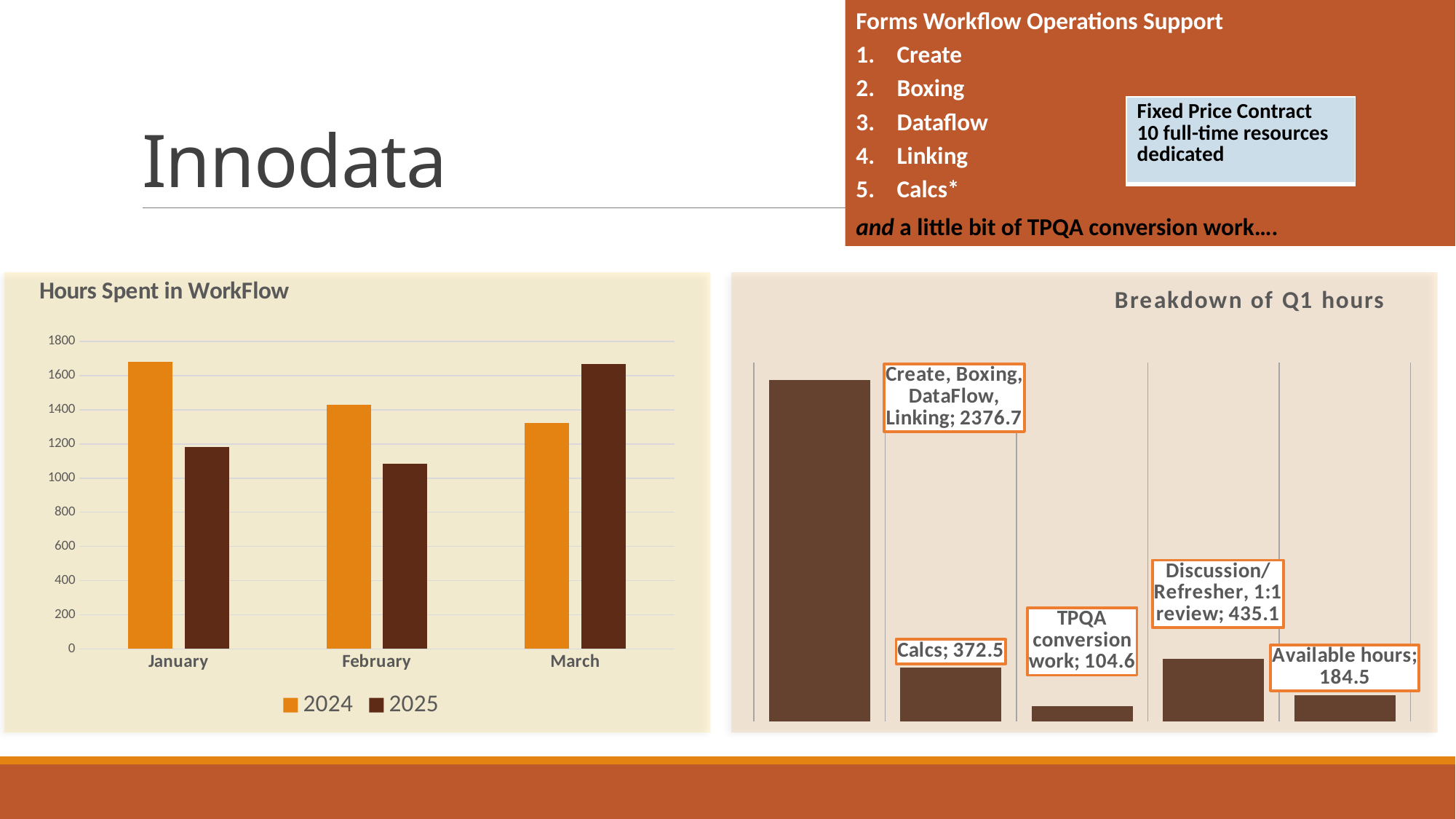
What kind of chart is 'Hours Spent in WorkFlow'? bar chart In the 'Breakdown of Q1 hours' chart, which category has the lowest value? TPQA conversion work In the 'Hours Spent in WorkFlow' chart, how many series does the legend list? 2 In the 'Breakdown of Q1 hours' chart, what is the value for TPQA conversion work? 104.6 In the 'Hours Spent in WorkFlow' chart, which is larger for March, 2024 or 2025? 2025 In the 'Breakdown of Q1 hours' chart, how many hours are shown for Calcs? 372.5 In the 'Hours Spent in WorkFlow' chart, do the 2024 values rise or fall from January to March? fall In the 'Hours Spent in WorkFlow' chart, is the 2024 value for January greater or less than 1600? greater In the 'Breakdown of Q1 hours' chart, what is the value for Discussion/Refresher, 1:1 review? 435.1 In the 'Breakdown of Q1 hours' chart, how many categories are plotted? 5 In the 'Breakdown of Q1 hours' chart, what is the difference between Discussion/Refresher, 1:1 review and Calcs? 62.6 In the 'Breakdown of Q1 hours' chart, which category has the highest value? Create, Boxing, DataFlow, Linking